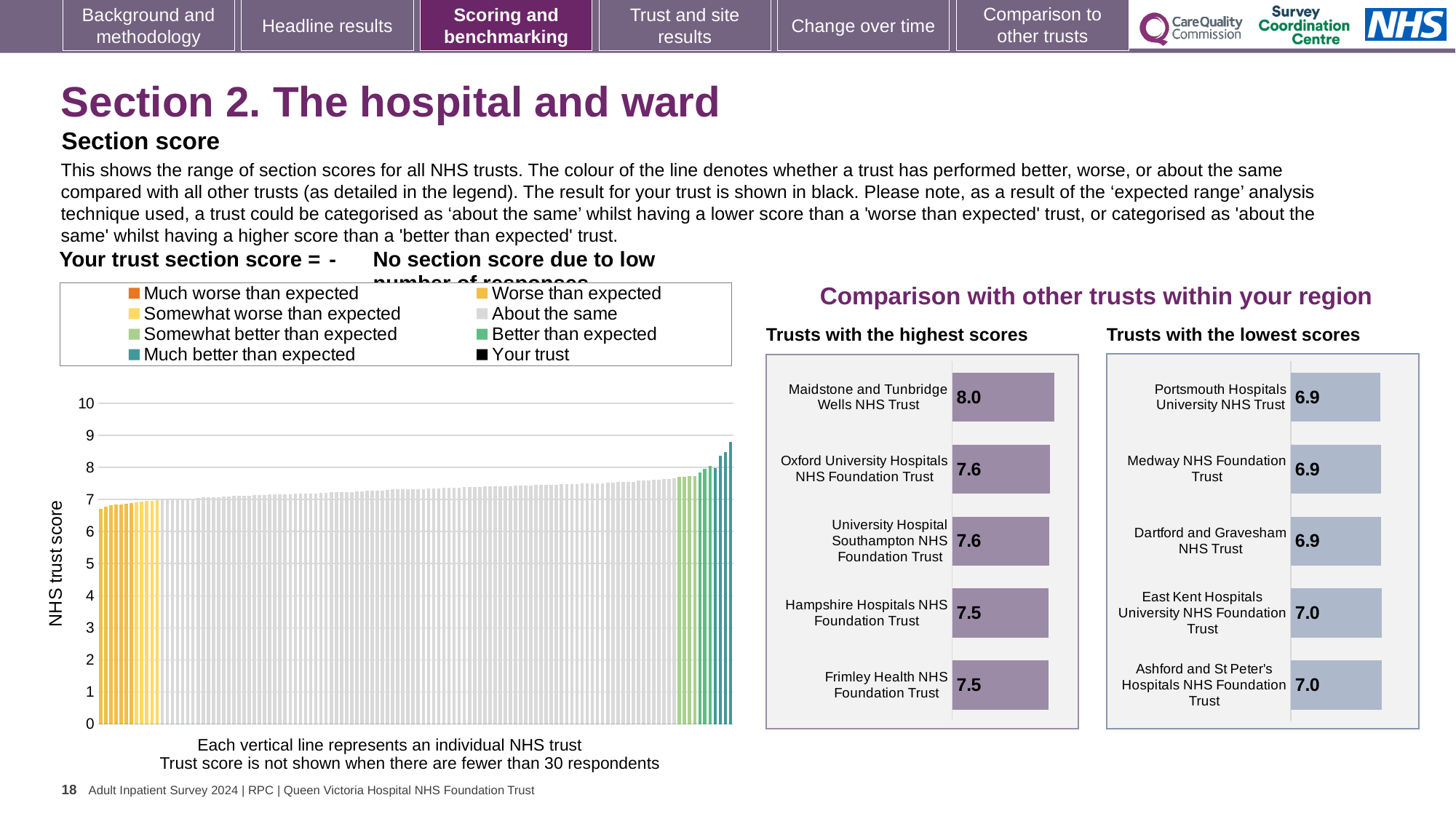
In the 'Trusts with the lowest scores' chart, what is the difference between the scores of East Kent Hospitals University NHS Foundation Trust and Medway NHS Foundation Trust? 0.1 In the 'Trusts with the highest scores' chart, what is the score for Maidstone and Tunbridge Wells NHS Trust? 8.0 Which is larger: the score for Maidstone and Tunbridge Wells NHS Trust in the highest scores chart, or the score for Ashford and St Peter's Hospitals NHS Foundation Trust in the lowest scores chart? Maidstone and Tunbridge Wells NHS Trust What is the y-axis label of the large chart on the left? NHS trust score In the 'Trusts with the highest scores' chart, which trust has the highest score? Maidstone and Tunbridge Wells NHS Trust In the 'Trusts with the highest scores' chart, what is the difference between the scores of Maidstone and Tunbridge Wells NHS Trust and Frimley Health NHS Foundation Trust? 0.5 How many trusts are shown in the 'Trusts with the highest scores' chart? 5 How many entries does the legend above the left-hand chart list? 8 What kind of chart is the large chart on the left showing NHS trust scores? Bar chart In the 'Trusts with the lowest scores' chart, what is the score for Portsmouth Hospitals University NHS Trust? 6.9 In the 'Trusts with the highest scores' chart, what is the score for Hampshire Hospitals NHS Foundation Trust? 7.5 In the 'Trusts with the lowest scores' chart, what is the score for East Kent Hospitals University NHS Foundation Trust? 7.0